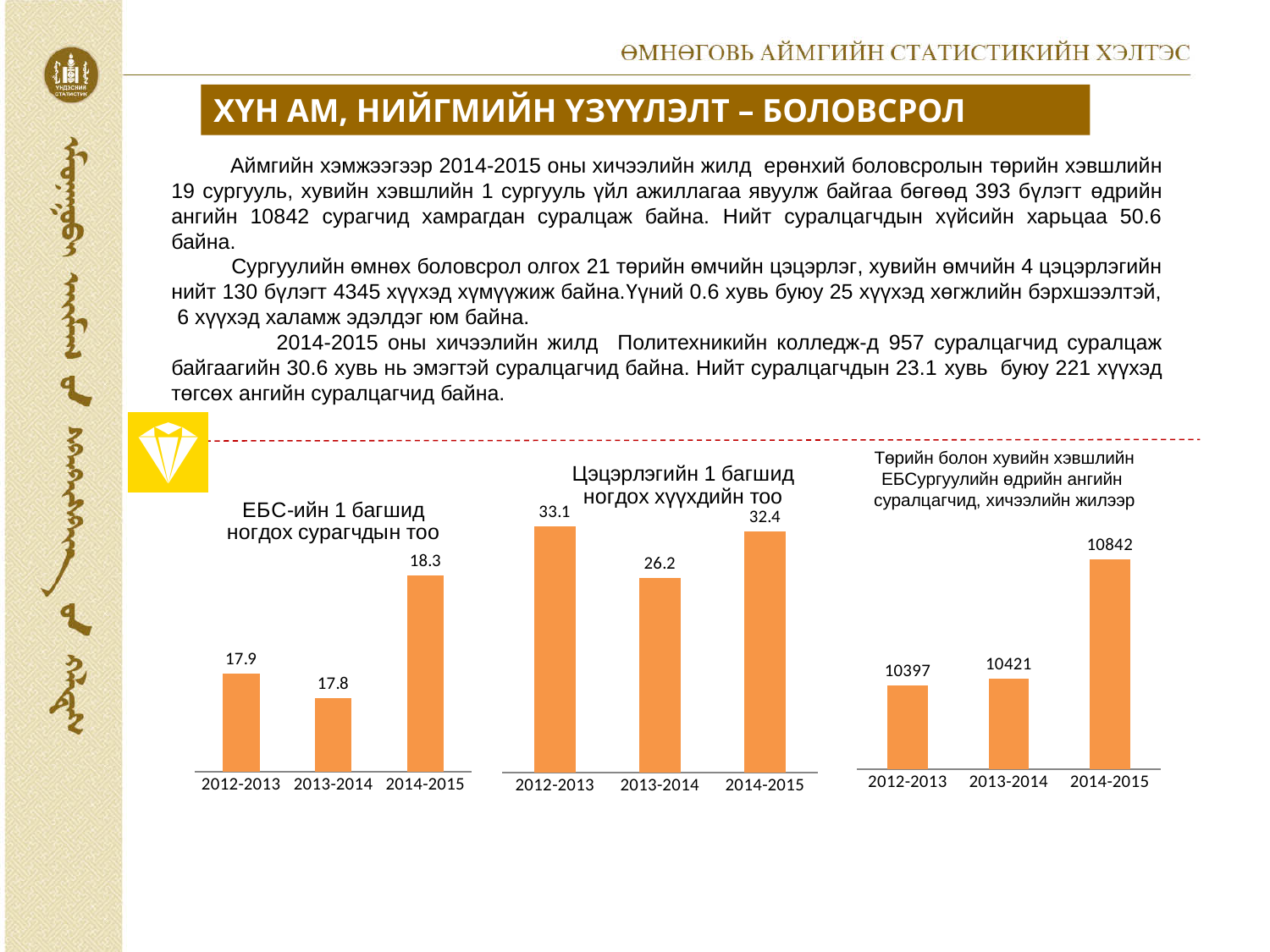
In the left chart (ЕБС-ийн 1 багшид ногдох сурагчдын тоо), what is the difference between the 2014-2015 and 2013-2014 values? 0.5 In the left chart (ЕБС-ийн 1 багшид ногдох сурагчдын тоо), which school year has the lowest value? 2013-2014 In the right chart (Төрийн болон хувийн хэвшлийн ЕБСургуулийн өдрийн ангийн суралцагчид), what is the difference between the 2014-2015 and 2013-2014 values? 421 In the right chart (Төрийн болон хувийн хэвшлийн ЕБСургуулийн өдрийн ангийн суралцагчид), which school year has the highest value? 2014-2015 In the right chart (Төрийн болон хувийн хэвшлийн ЕБСургуулийн өдрийн ангийн суралцагчид), do the values rise or fall from 2012-2013 to 2014-2015? rise In the middle chart (Цэцэрлэгийн 1 багшид ногдох хүүхдийн тоо), which school year has the highest value? 2012-2013 How many school years are shown in the middle chart (Цэцэрлэгийн 1 багшид ногдох хүүхдийн тоо)? 3 What kind of chart is the left chart (ЕБС-ийн 1 багшид ногдох сурагчдын тоо)? bar chart In the right chart (Төрийн болон хувийн хэвшлийн ЕБСургуулийн өдрийн ангийн суралцагчид), what is the value for 2012-2013? 10397 In the middle chart (Цэцэрлэгийн 1 багшид ногдох хүүхдийн тоо), what is the difference between the 2012-2013 and 2014-2015 values? 0.7 In the middle chart (Цэцэрлэгийн 1 багшид ногдох хүүхдийн тоо), what is the value for 2013-2014? 26.2 In the left chart (ЕБС-ийн 1 багшид ногдох сурагчдын тоо), what is the value for 2014-2015? 18.3